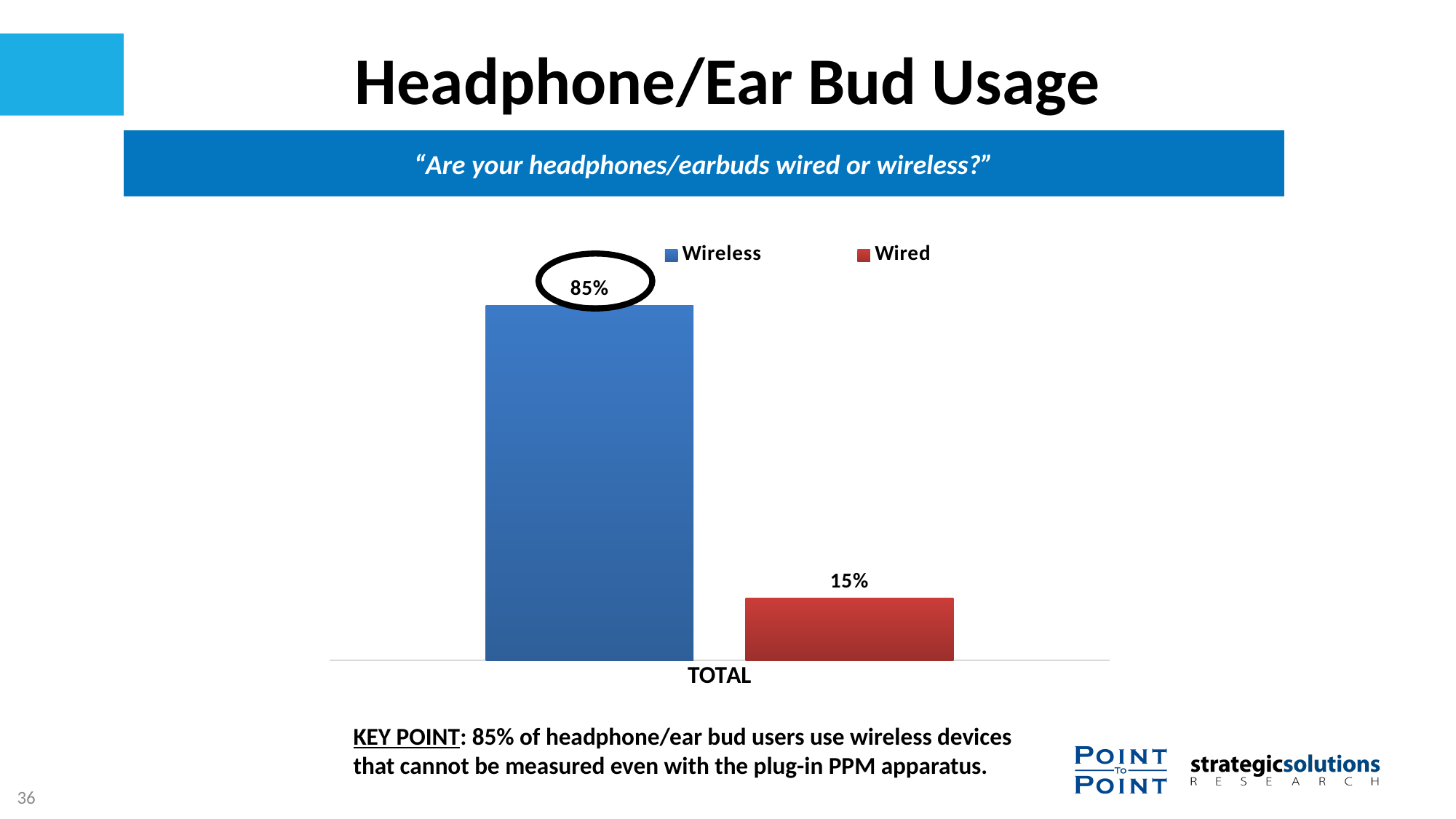
What is the difference in percentage points between the Wireless and Wired values? 70 Which series has the higher value, Wireless or Wired? Wireless How many series does the legend list? 2 What percentage of respondents use wired headphones/earbuds? 15% What kind of chart is shown on the slide? bar chart What is the category label shown on the x axis? TOTAL Which series has the lower value, Wireless or Wired? Wired What colour is the bar for the Wired series? red What percentage of respondents use wireless headphones/earbuds? 85% Is the value for Wired larger or smaller than the value for Wireless? smaller What is the sum of the Wireless and Wired values? 100%